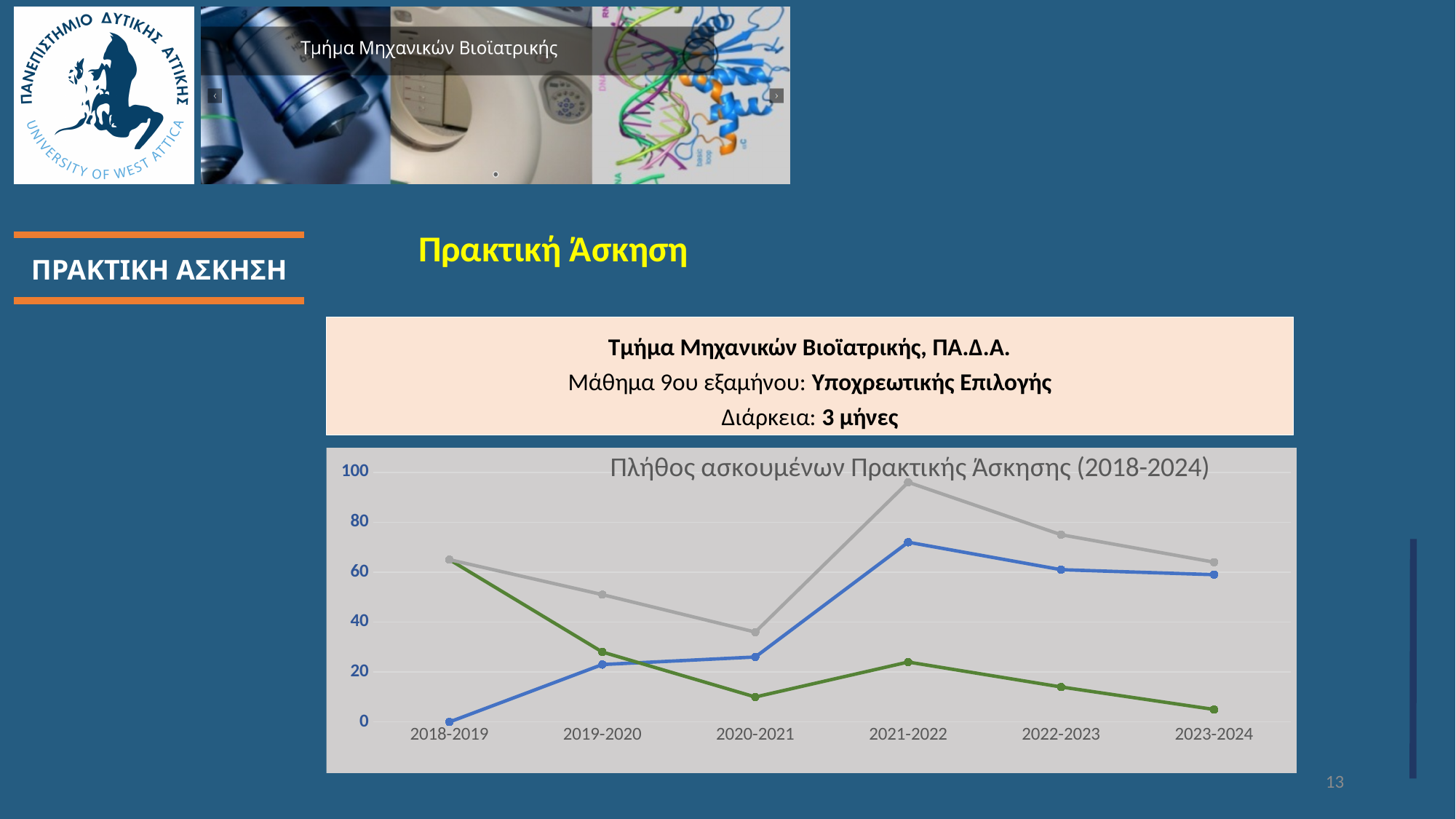
Does the green line rise or fall overall from 2018-2019 to 2023-2024? fall Is the value of the green line for 2023-2024 greater or less than 20? less In which academic year does the gray line reach its highest value? 2021-2022 Is the value of the gray line for 2021-2022 greater or less than 80? greater How many lines are plotted in the chart? 3 In which academic year does the blue line reach its highest value? 2021-2022 What is the title of the chart? Πλήθος ασκουμένων Πρακτικής Άσκησης (2018-2024) For 2021-2022, which line has the larger value, the gray line or the blue line? gray line What is the value of the blue line for 2018-2019? 0 What kind of chart is shown on the slide? line chart In which academic year does the green line reach its lowest value? 2023-2024 How many academic years are shown on the x axis of the chart? 6